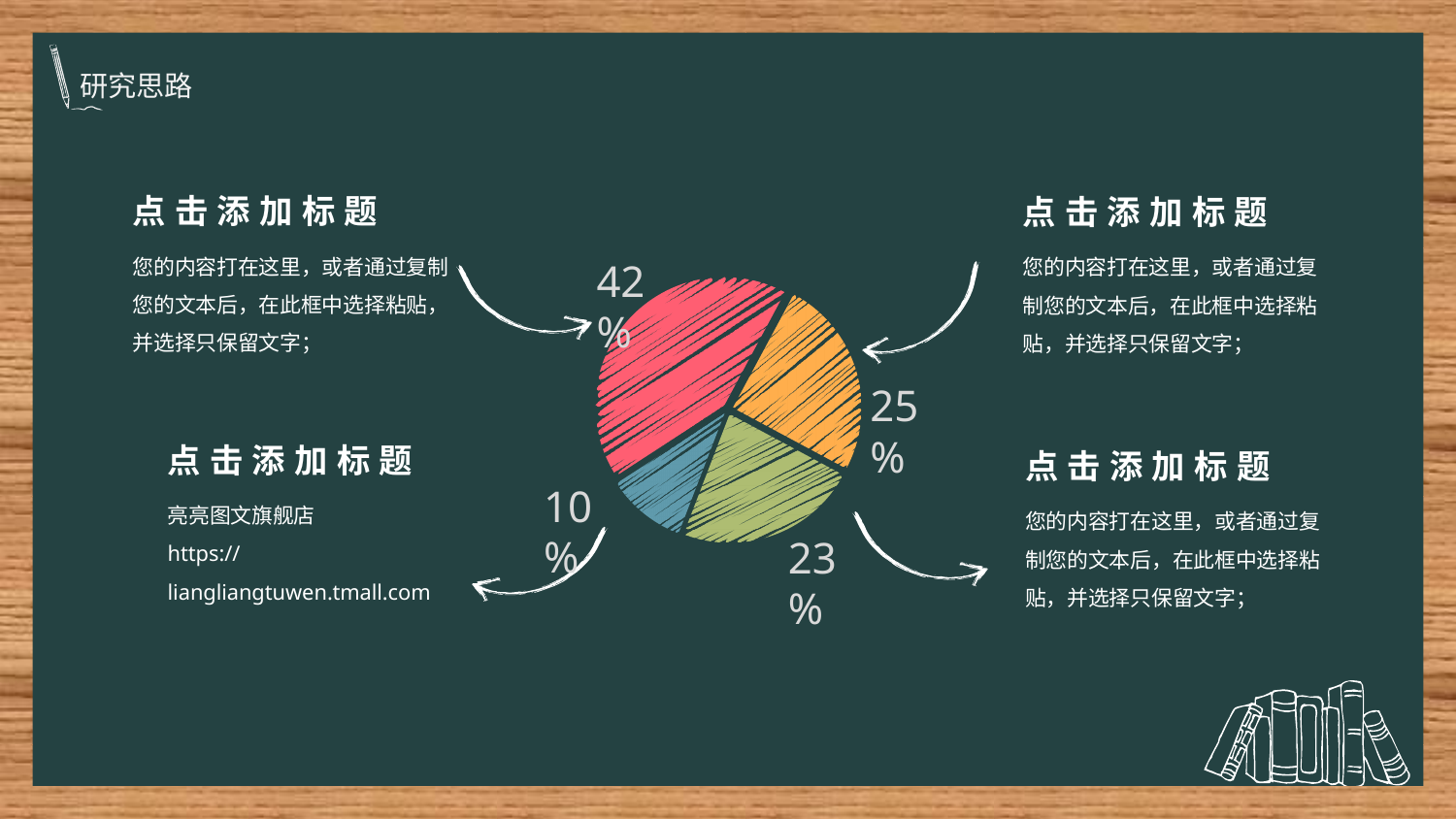
What percentage is shown for the blue slice of the pie chart? 10% Which slice of the pie chart is the smallest? the blue slice (10%) Which is larger, the orange slice or the green slice? the orange slice How many slices does the pie chart have? 4 What is the difference in percentage points between the red slice and the blue slice? 32 What percentage is shown for the green slice of the pie chart? 23% What percentage is shown for the orange slice of the pie chart? 25% What percentage is shown for the red slice of the pie chart? 42% What is the combined share of the red and orange slices? 67% What kind of chart is shown on the slide? pie chart What is the difference in percentage points between the orange slice and the green slice? 2 Which slice of the pie chart is the largest? the red slice (42%)